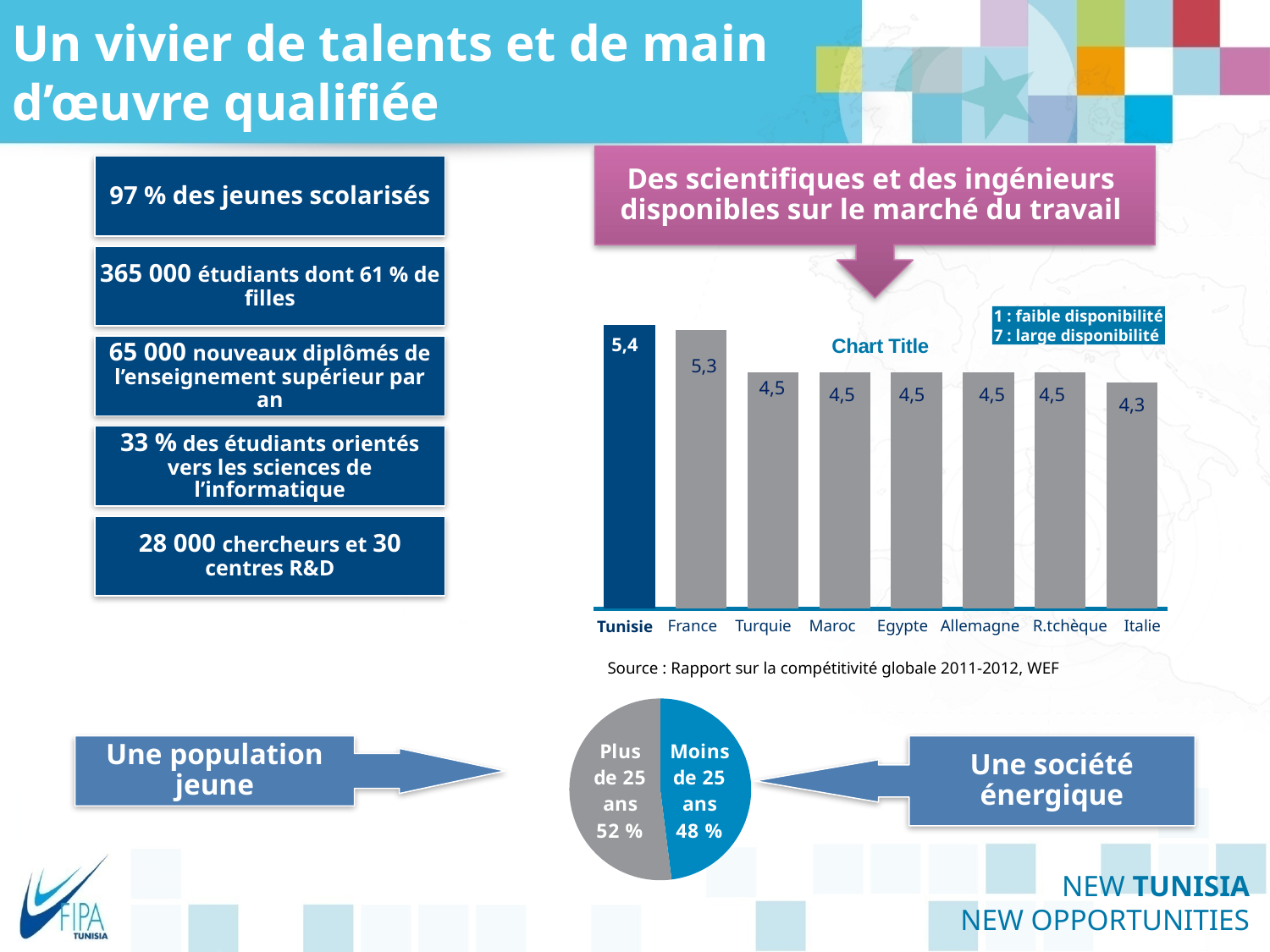
In the bar chart in the upper right of the slide, what is the value for Tunisie? 5,4 What kind of chart is the chart in the upper right of the slide? Bar chart In the bar chart in the upper right of the slide, which is larger, the value for France or the value for Italie? France In the bar chart in the upper right of the slide, how many countries are shown? 8 In the bar chart in the upper right of the slide, what is the value for Italie? 4,3 In the bar chart in the upper right of the slide, what is the difference between the values for Tunisie and Italie? 1,1 In the bar chart in the upper right of the slide, which country has the highest value? Tunisie In the pie chart at the bottom of the slide, what share is 'Plus de 25 ans'? 52 % In the bar chart in the upper right of the slide, what is the value for France? 5,3 In the bar chart in the upper right of the slide, do the values rise or fall from left to right? Fall In the pie chart at the bottom of the slide, how many slices are there? 2 In the bar chart in the upper right of the slide, which country has the lowest value? Italie